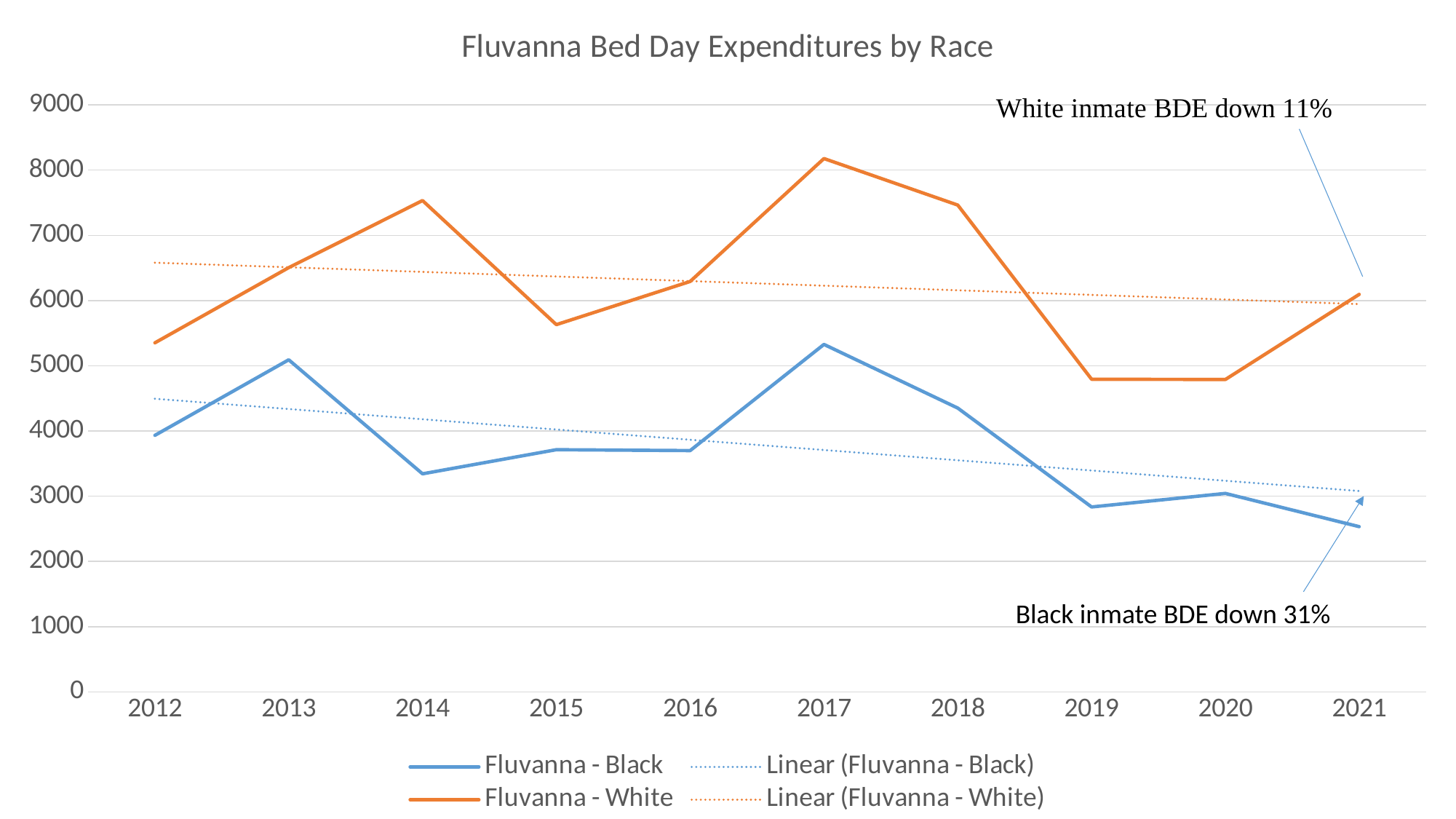
Which is larger in 2016, the Fluvanna - Black value or the Fluvanna - White value? Fluvanna - White In which year is the Fluvanna - Black value lowest? 2021 How many years are shown on the x axis? 10 According to the annotation on the chart, by what percentage is Black inmate BDE down? 31% What is the title of the chart? Fluvanna Bed Day Expenditures by Race Is the Fluvanna - White value for 2014 greater or less than 7000? greater Does the Linear (Fluvanna - Black) trendline rise or fall from 2012 to 2021? fall In which year is the Fluvanna - White value highest? 2017 Is the Fluvanna - Black value for 2021 greater or less than 3000? less Is the Fluvanna - White value for 2019 greater or less than 5000? less What kind of chart is shown on the slide? line chart How many series does the legend list? 4